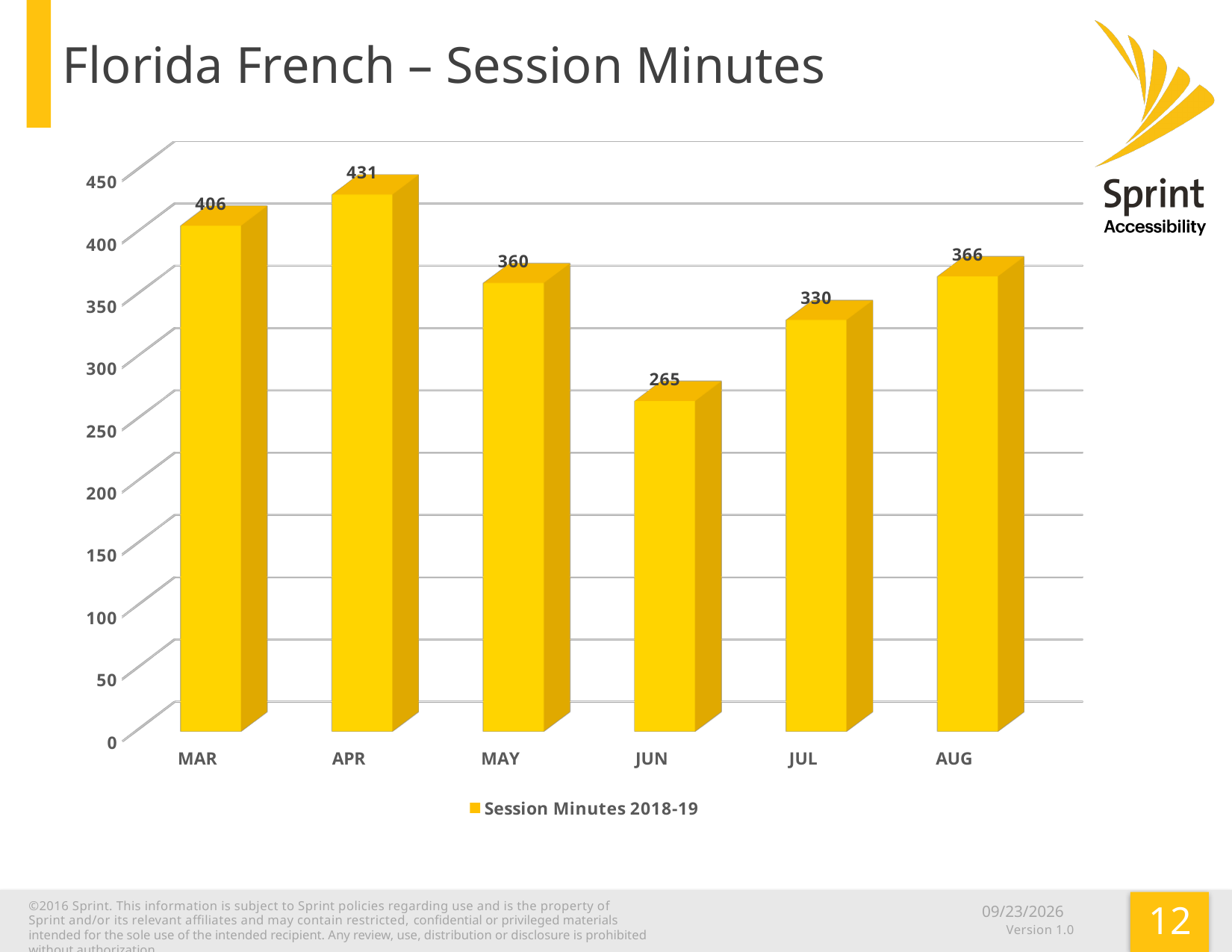
What is the value for AUG? 366 Which is larger, the value for JUL or the value for AUG? AUG What is the value for JUN? 265 Which month has the lowest session minutes? JUN What is the difference between the values for APR and JUN? 166 What is the difference between the values for MAR and MAY? 46 How many months are shown on the x axis? 6 Which month has the highest session minutes? APR Is the value for MAY greater or less than 300? greater What is the value for APR? 431 What kind of chart is shown on the slide? bar chart What is the legend entry for the series shown? Session Minutes 2018-19